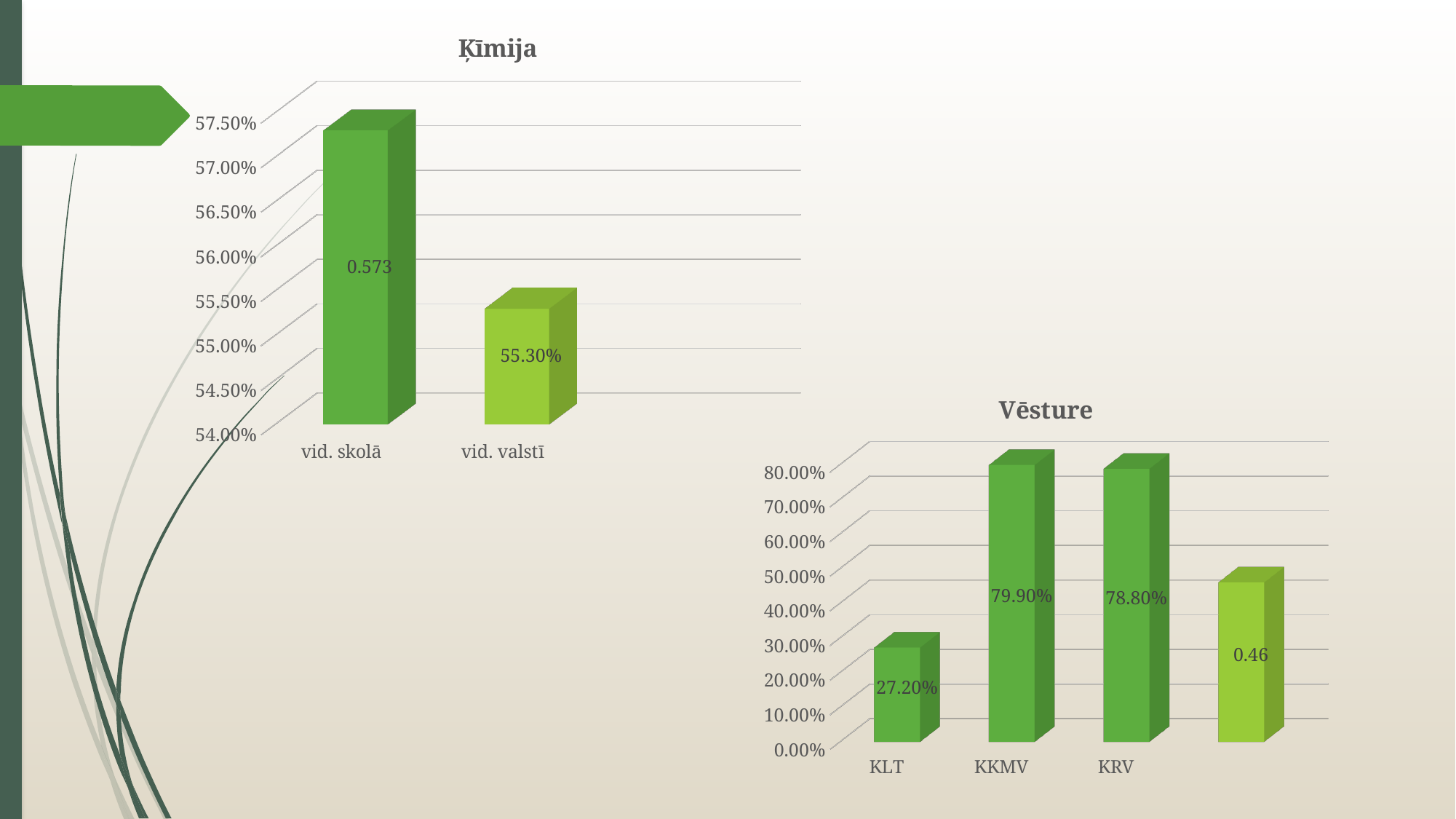
In the Ķīmija chart, how many categories are shown on the x axis? 2 In the Ķīmija chart, which category has the taller bar, vid. skolā or vid. valstī? vid. skolā In the Ķīmija chart, what value is shown for vid. skolā? 0.573 In the Vēsture chart, which labelled category has the lowest value? KLT In the Vēsture chart, what value is shown for KKMV? 79.90% In the Vēsture chart, which labelled category has the highest value? KKMV In the Vēsture chart, is the value for KLT greater or less than 30%? less In the Ķīmija chart, what value is shown for vid. valstī? 55.30% In the Vēsture chart, what value is shown for KRV? 78.80% In the Vēsture chart, what value is shown for KLT? 27.20% What kind of chart is the Ķīmija chart? bar chart In the Vēsture chart, what is the difference between the values for KKMV and KRV? 1.10%